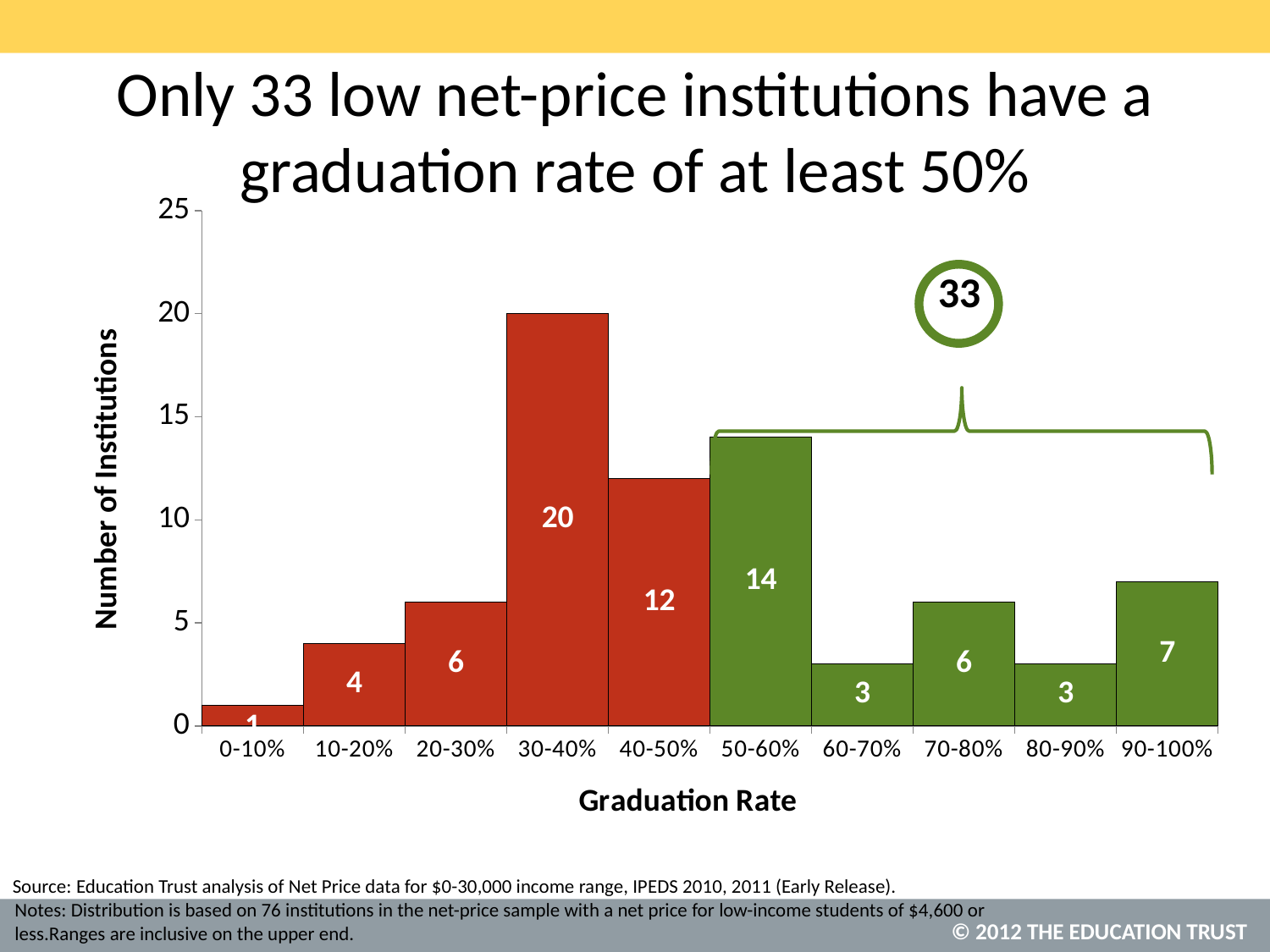
How many institutions have a graduation rate of 30-40%? 20 How many institutions have a graduation rate of 90-100%? 7 Which graduation rate range has the lowest number of institutions? 0-10% Which has more institutions, the 20-30% range or the 10-20% range? 20-30% What is the label of the y axis? Number of Institutions What kind of chart is shown on the slide? bar chart What is the difference in the number of institutions between the 30-40% and 40-50% ranges? 8 What number is shown in the circle above the bracket spanning the green bars? 33 Which graduation rate range has the highest number of institutions? 30-40% How many graduation rate ranges are shown on the x axis? 10 How many institutions have a graduation rate of 50-60%? 14 Is the number of institutions in the 40-50% range greater or less than 10? greater